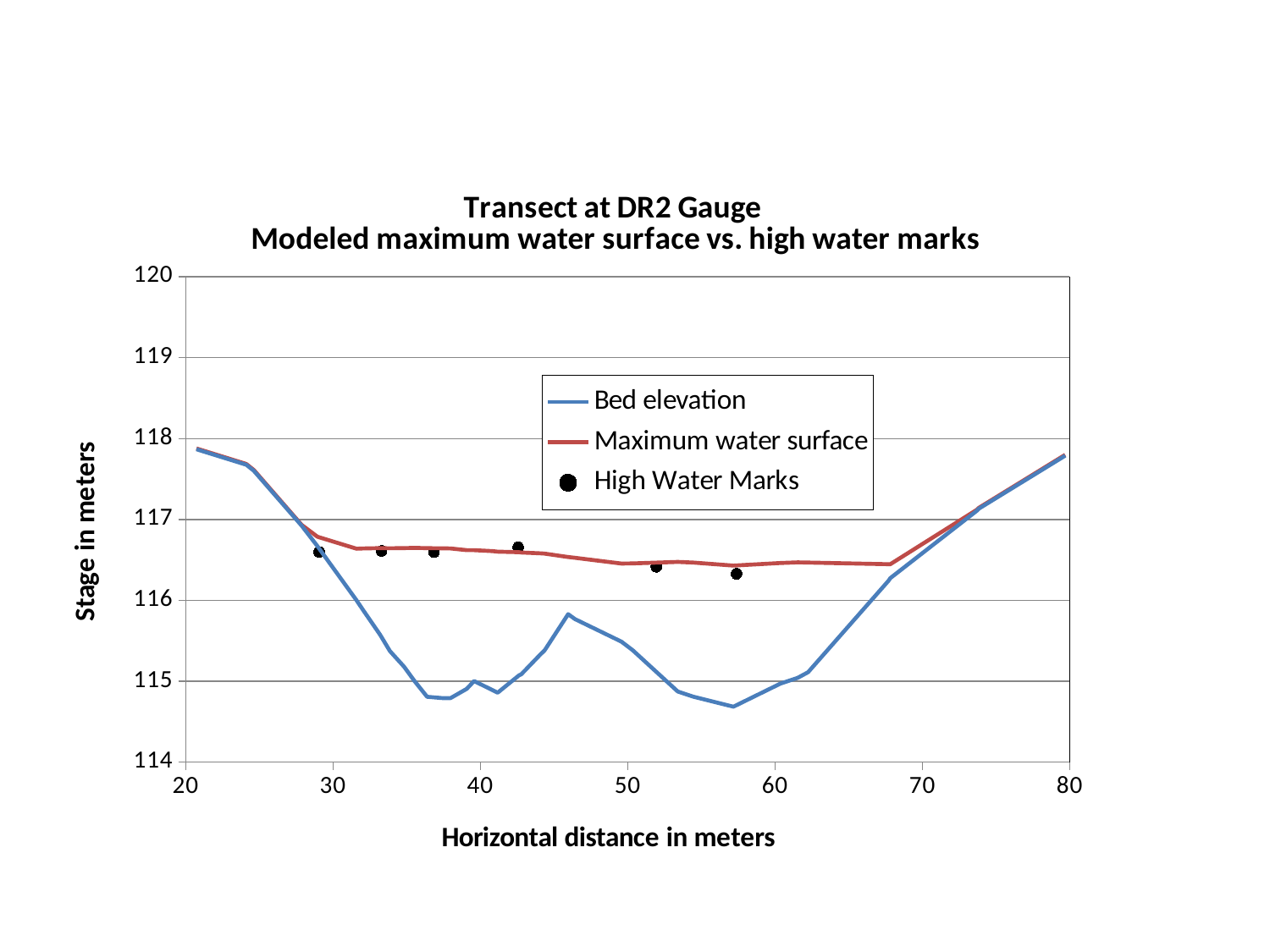
How many High Water Marks points are plotted on the chart? 6 How many series does the legend list? 3 What is the title of the y axis? Stage in meters Does the Bed elevation rise or fall as horizontal distance increases from 20 to 37 meters? fall Is the Bed elevation at a horizontal distance of 70 meters greater or less than 116? greater Is the Bed elevation at a horizontal distance of 57 meters greater or less than 115? less Is the Bed elevation at a horizontal distance of 30 meters greater or less than 116? greater What colour is the Maximum water surface line? red Does the Bed elevation rise or fall as horizontal distance increases from 62 to 80 meters? rise What kind of chart is shown on the slide? line chart At a horizontal distance of 50 meters, which is higher: the Bed elevation or the Maximum water surface? Maximum water surface